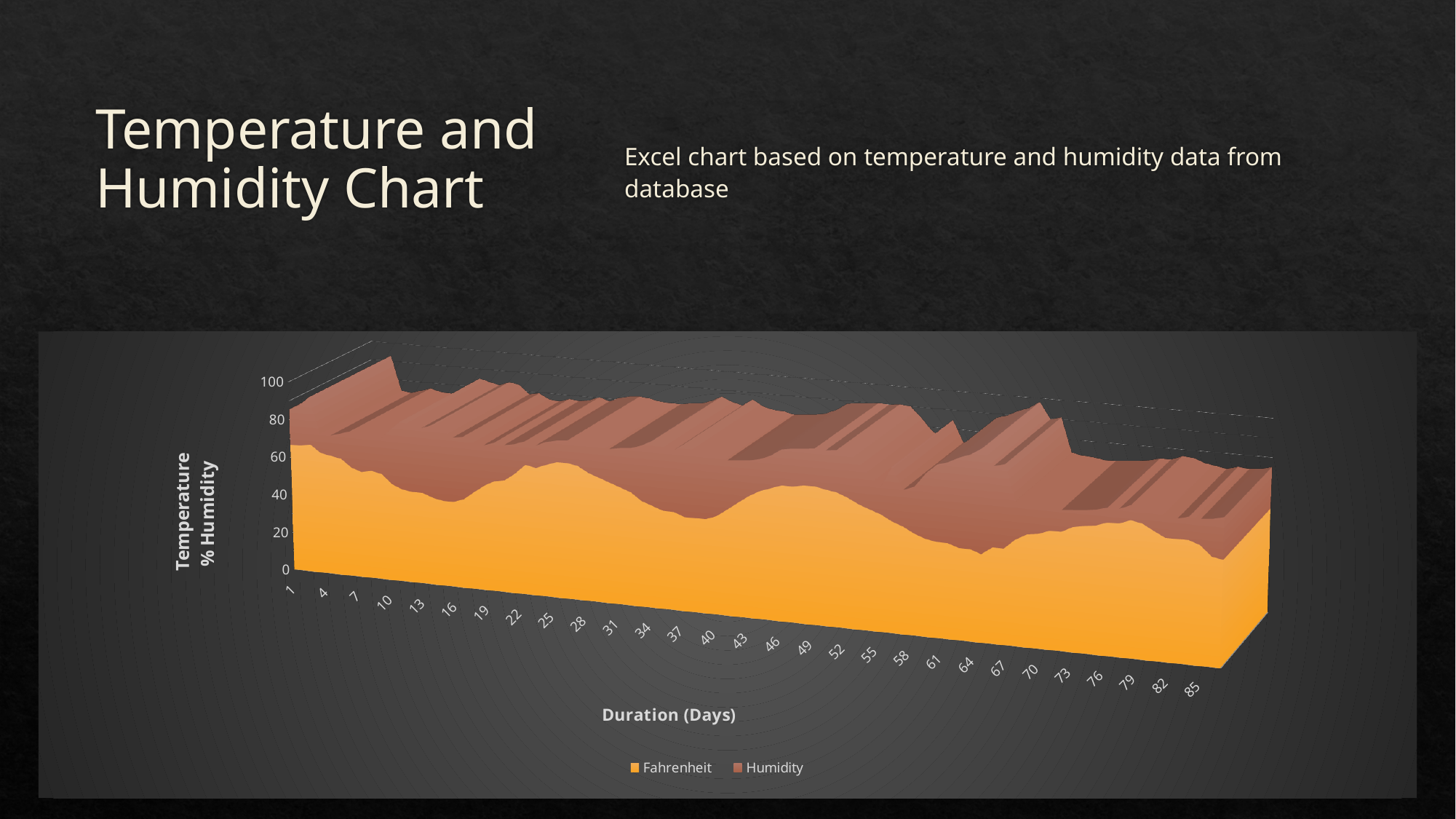
What are the two series named in the chart's legend? Fahrenheit and Humidity Is the Humidity value at day 1 greater or less than 60? less What kind of chart is shown on the slide? Area chart What is the highest value shown on the chart's vertical axis? 100 How many day labels are printed along the chart's horizontal axis? 29 What is the interval between consecutive tick labels on the chart's vertical axis? 20 How many series does the chart's legend list? 2 What is the title of the chart's horizontal axis? Duration (Days) Is the Fahrenheit value at day 1 greater or less than 40? greater What is the last day label shown on the chart's horizontal axis? 85 What is the first day label shown on the chart's horizontal axis? 1 At day 1, which series has the larger value, Fahrenheit or Humidity? Fahrenheit